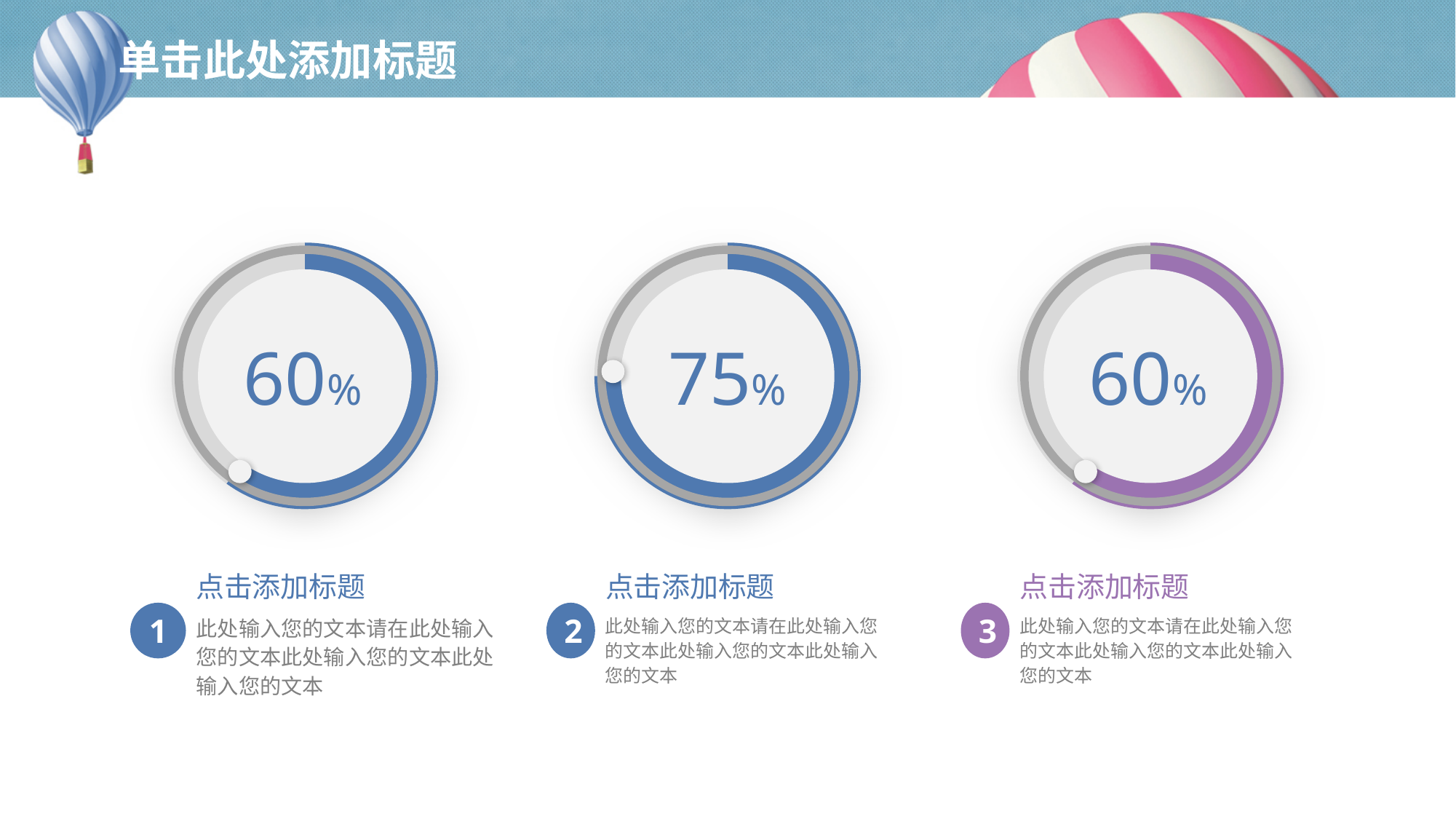
What value is shown in the middle circular chart? 75% What value is shown in the left circular chart? 60% Do the left and right circular charts show the same value? yes Which of the three circular charts shows the highest value? the middle chart Is the value in the middle chart greater or less than 50%? greater Is the value in the middle chart larger or smaller than the value in the right chart? larger What colour is the filled ring of the middle circular chart? blue How many circular charts are on the slide? 3 What is the difference between the value in the middle chart and the value in the left chart? 15% What value is shown in the right circular chart? 60% What colour is the filled ring of the right circular chart? purple What kind of chart is used to display the percentages on the slide? circular progress (donut) chart